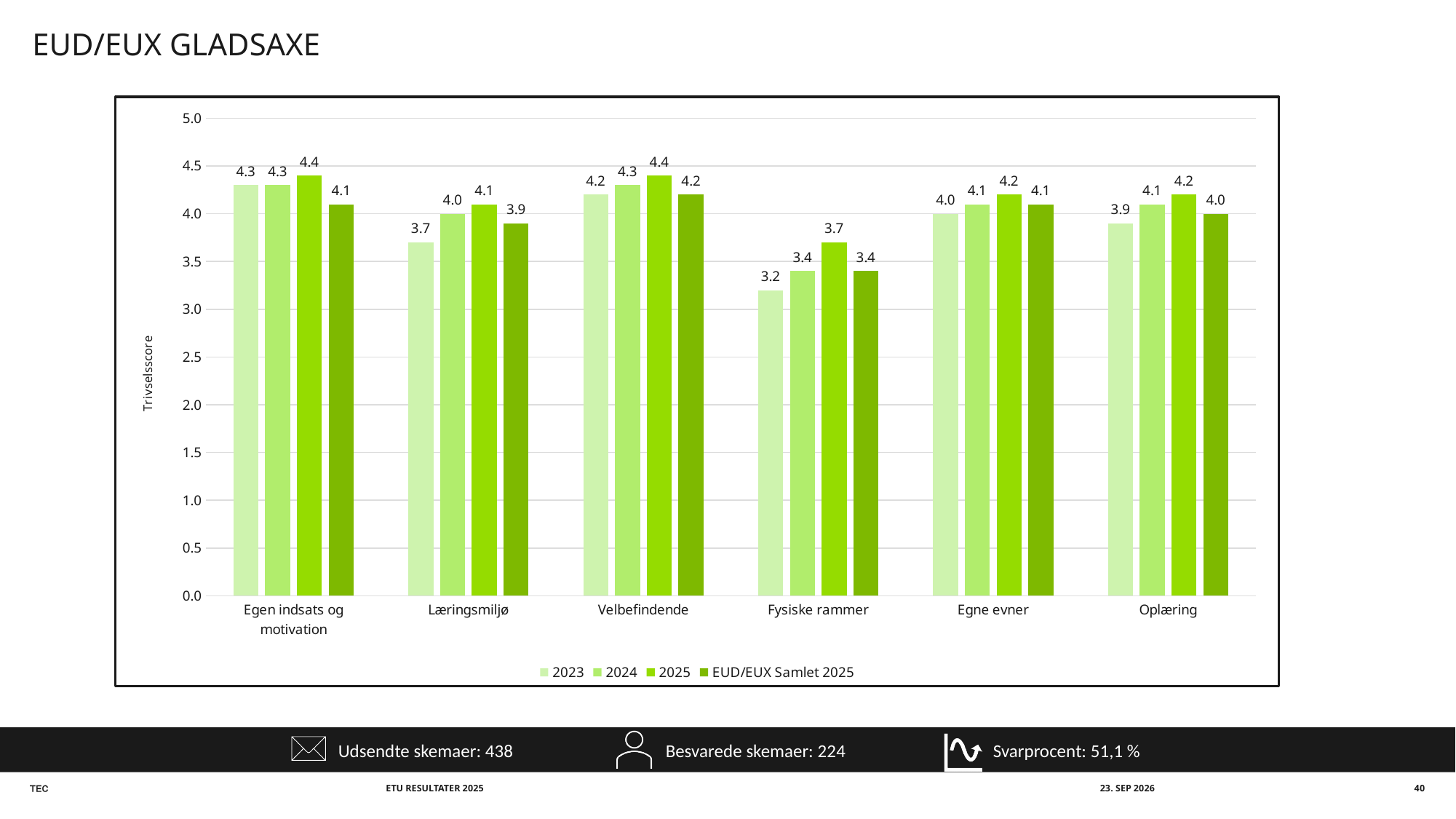
What is the difference between the 2025 value and the 2023 value for Fysiske rammer? 0.5 What is the label of the y axis? Trivselsscore What is the 2023 value for Læringsmiljø? 3.7 What is the EUD/EUX Samlet 2025 value for Oplæring? 4.0 Which category has the highest 2024 value? Velbefindende What kind of chart is shown on the slide? bar chart Which category has the lowest 2023 value? Fysiske rammer Is the 2023 value for Fysiske rammer greater or less than 3.5? less What is the 2025 value for Fysiske rammer? 3.7 How many categories are shown on the x axis? 6 How many series does the legend list? 4 Which is larger for Læringsmiljø: the 2025 value or the EUD/EUX Samlet 2025 value? 2025